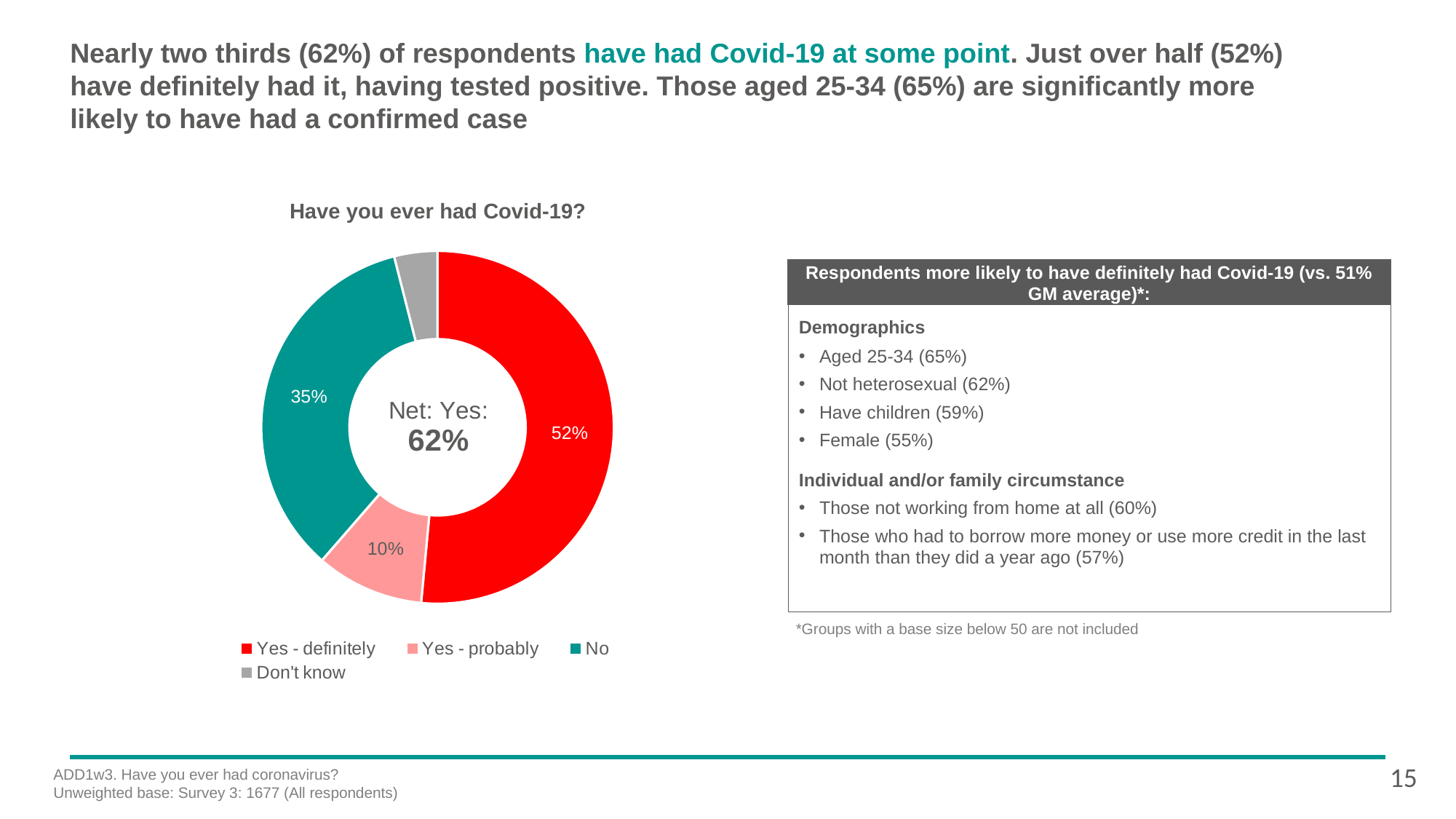
What percentage of respondents answered 'Yes - probably'? 10% Which response category has the largest share of the chart? Yes - definitely What percentage of respondents answered 'Yes - definitely'? 52% Which is larger, the 'No' share or the 'Yes - probably' share? No What percentage of respondents answered 'No'? 35% Which response category has the smallest share of the chart? Don't know How many response categories does the legend list? 4 What colour represents the 'No' category in the chart? Teal (green) What is the title of the chart? Have you ever had Covid-19? What kind of chart is shown on the slide? Donut (pie) chart What is the Net: Yes figure shown in the centre of the chart? 62% What is the difference between the 'Yes - definitely' and 'No' shares? 17 percentage points